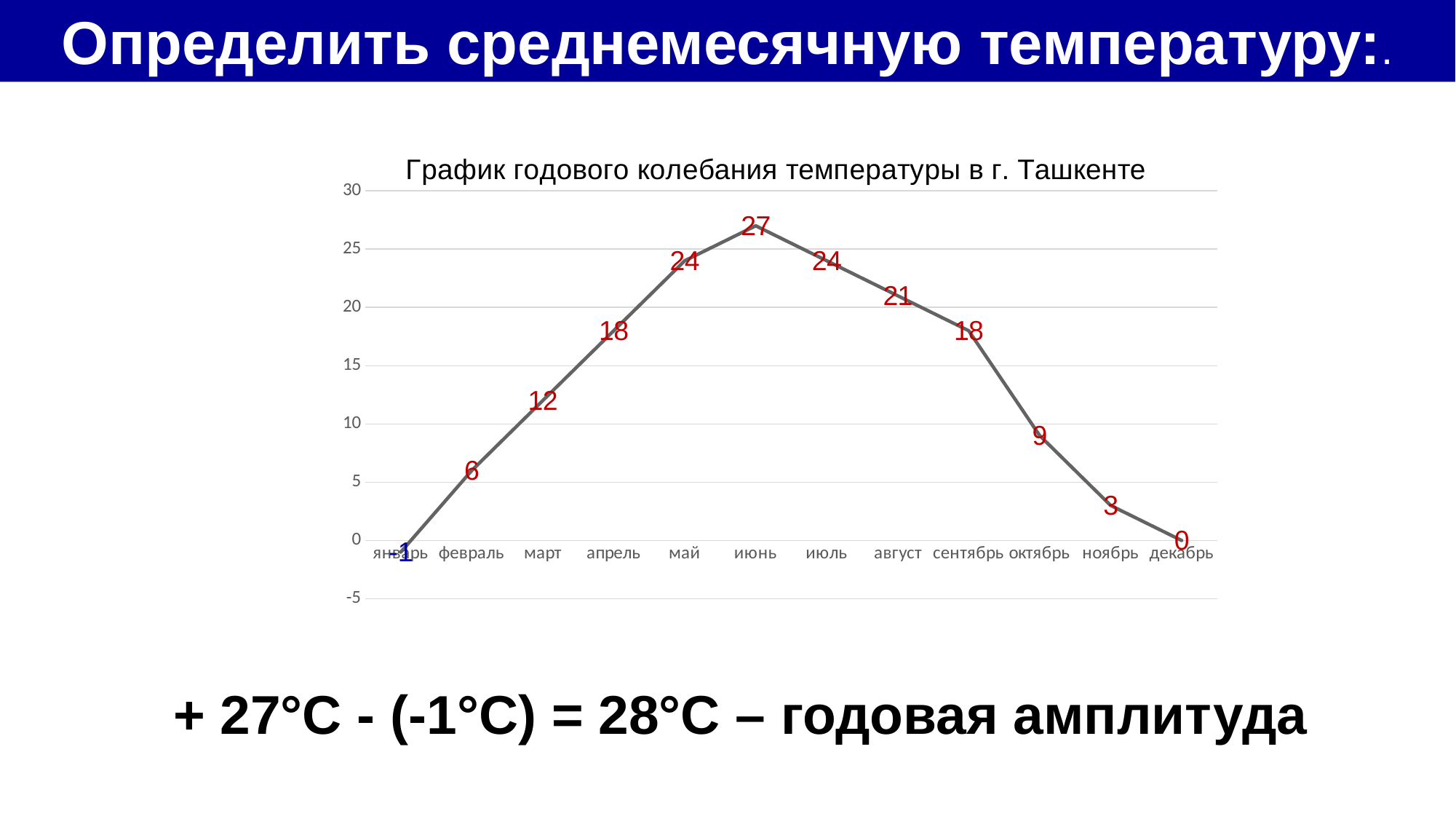
What is the temperature value for декабрь? 0 Is the value for сентябрь greater or less than 15? greater How many months (data points) are plotted on the chart? 12 What is the difference between the values for июнь and август? 6 What is the temperature value for октябрь? 9 What is the title of the chart? График годового колебания температуры в г. Ташкенте Which month has the lowest temperature on the chart? январь Which month has the highest temperature on the chart? июнь Which is larger, the value for март or the value for ноябрь? март What type of chart is shown on the slide? line chart Do the values rise or fall from июнь to декабрь? fall What is the temperature value for июнь? 27